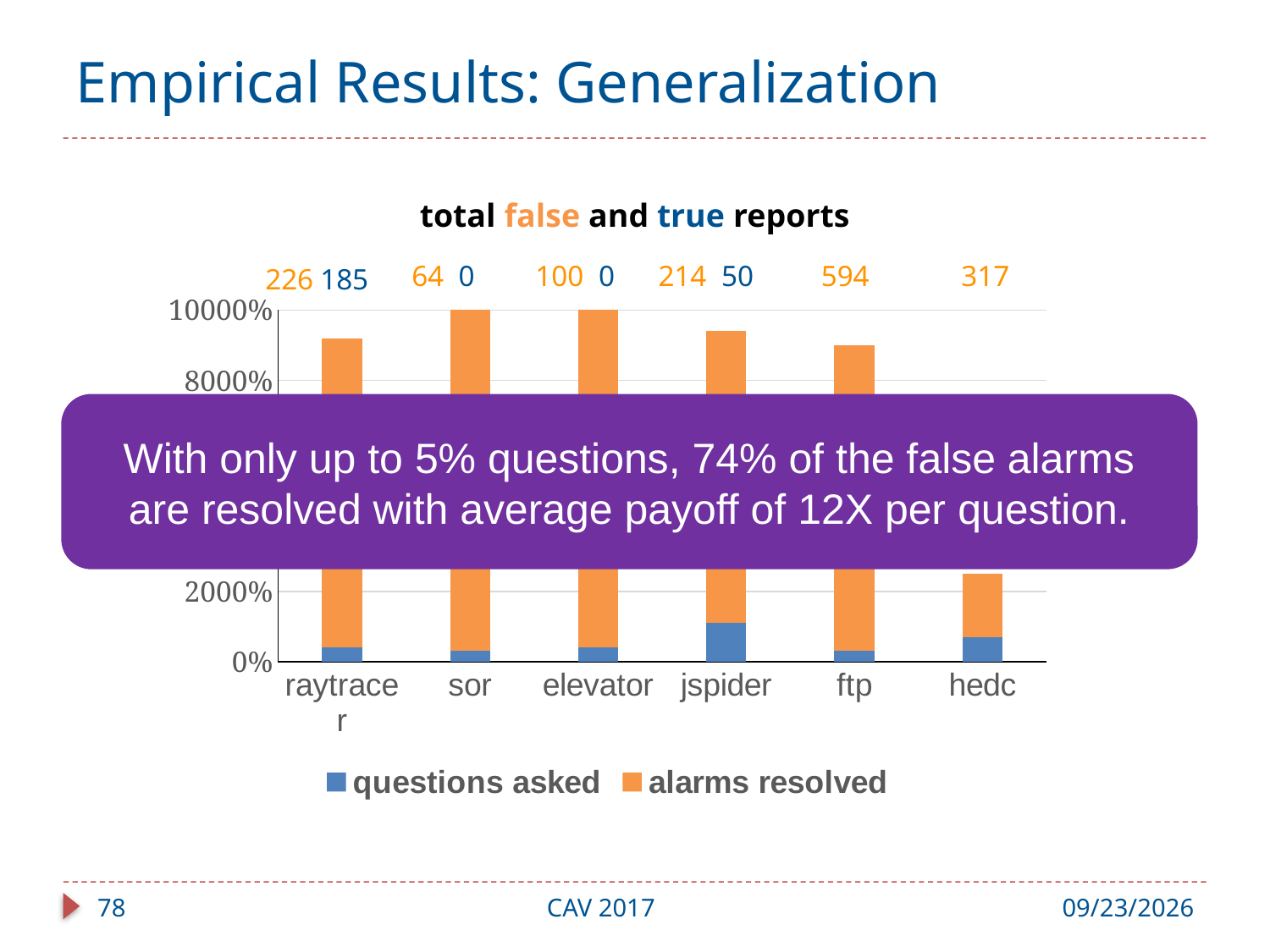
What number of false reports is printed above the ftp bar? 594 What number of true reports is printed above the raytracer bar? 185 What is the title of the chart? total false and true reports Which category has the largest 'questions asked' segment? jspider Is the total stacked bar for hedc greater or less than 8000%? less What kind of chart is shown on the slide? stacked bar chart Which category has the lowest total stacked bar? hedc How many series does the chart's legend list? 2 Which has the larger 'questions asked' segment, jspider or ftp? jspider How many categories are shown along the x axis of the chart? 6 What are the two series named in the chart's legend? questions asked, alarms resolved Is the total stacked bar for sor greater or less than 8000%? greater